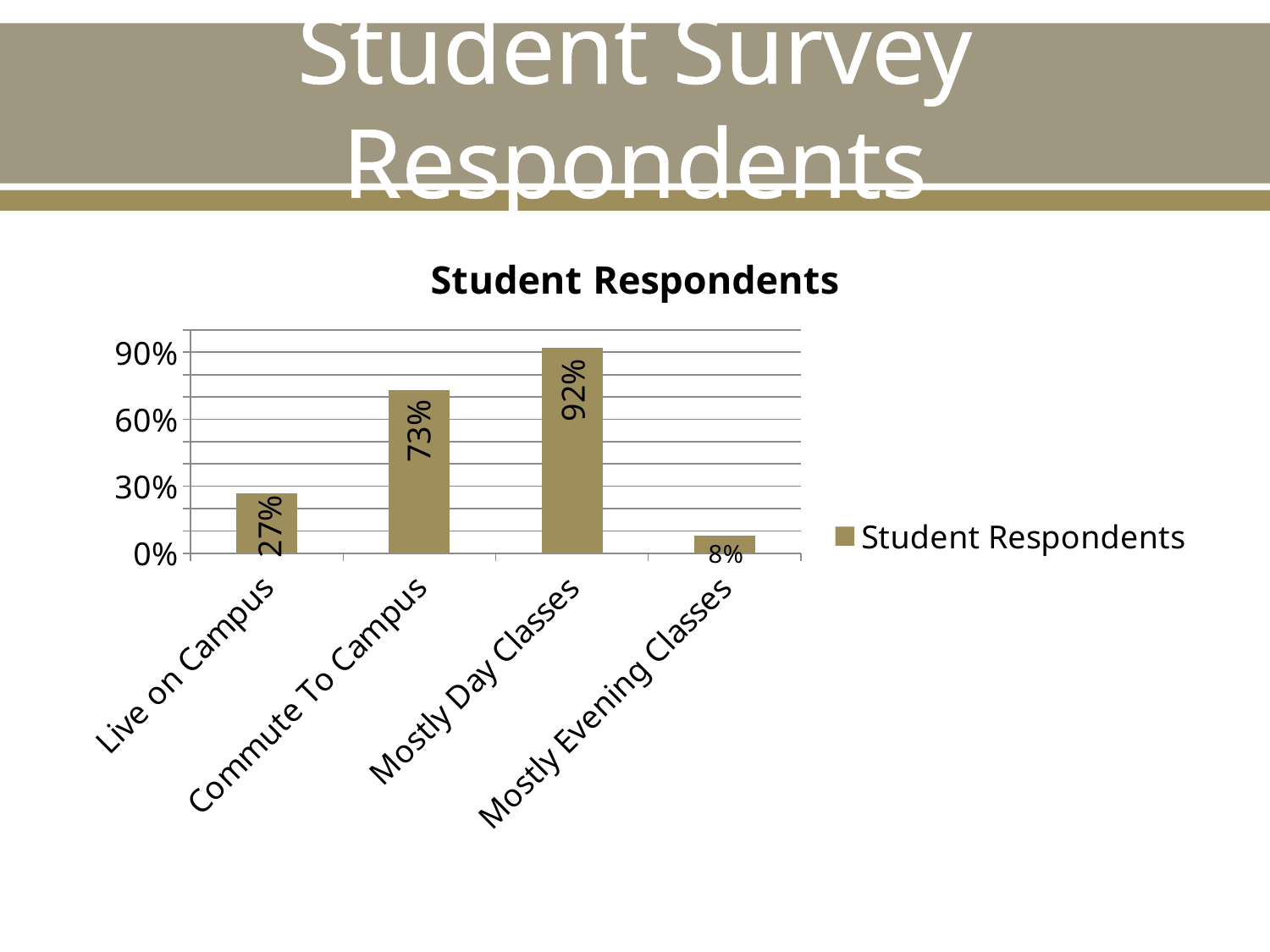
What is the value for Commute To Campus? 73% What percentage of student respondents live on campus? 27% What is the difference between the values for Commute To Campus and Live on Campus? 46% Is the value for Commute To Campus greater or less than 60%? greater What kind of chart is shown on the slide? bar chart Which category has the highest value? Mostly Day Classes Which category has the lowest value? Mostly Evening Classes What is the value for Mostly Day Classes? 92% Which is larger, the value for Live on Campus or the value for Mostly Evening Classes? Live on Campus What is the value for Mostly Evening Classes? 8% How many categories are shown on the x axis? 4 What is the title of the chart? Student Respondents